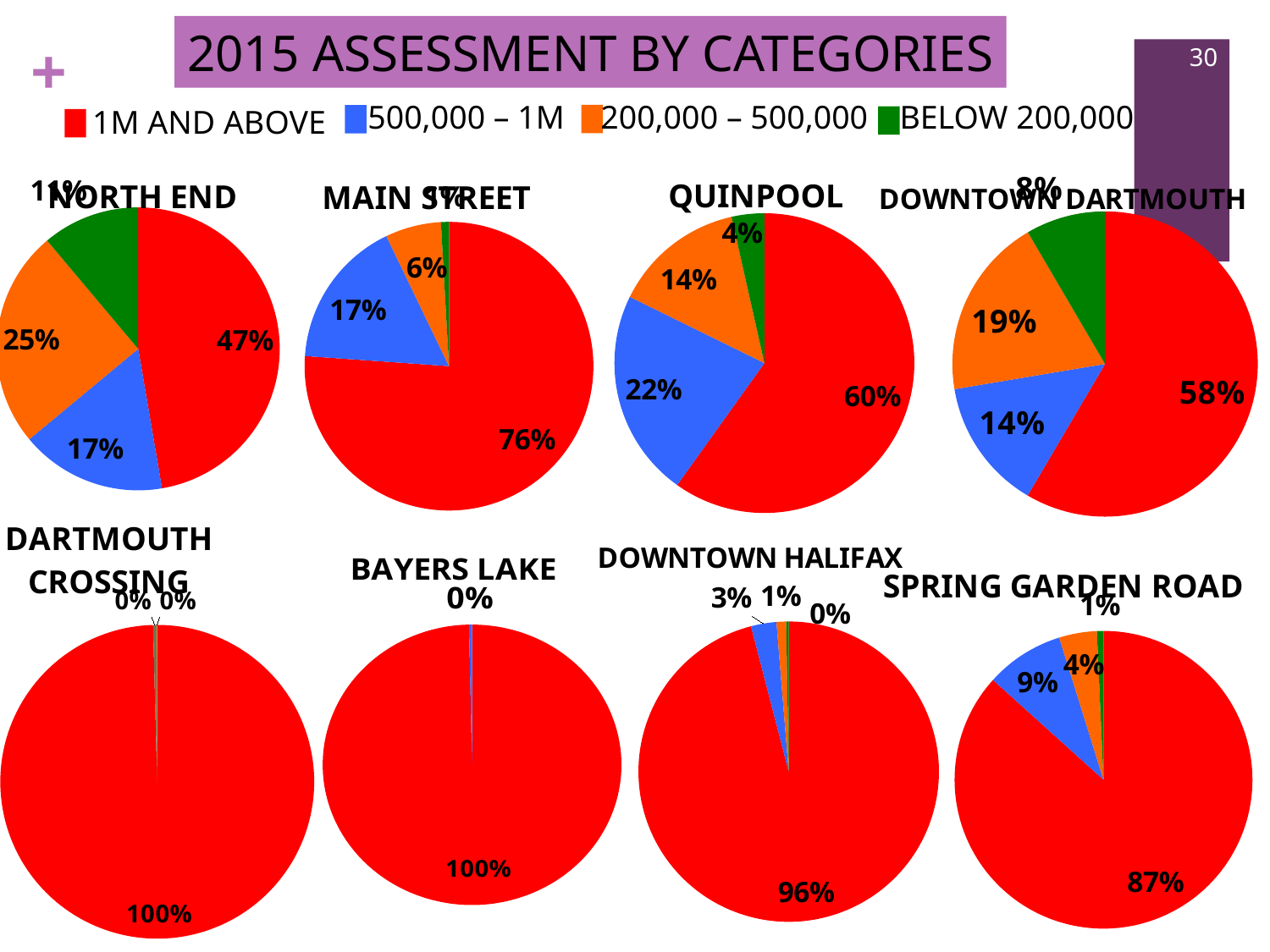
What type of chart is used for BAYERS LAKE? Pie chart In the NORTH END pie chart, what share is shown for the 1M AND ABOVE category? 47% In the QUINPOOL pie chart, what share is shown for the BELOW 200,000 category? 4% Which is larger in the NORTH END pie chart: the 200,000 – 500,000 share or the 500,000 – 1M share? 200,000 – 500,000 In the MAIN STREET pie chart, what share is shown for the 500,000 – 1M category? 17% How many categories does the legend list? 4 In the SPRING GARDEN ROAD pie chart, what share is shown for the 1M AND ABOVE category? 87% In the QUINPOOL pie chart, which category has the smallest share? BELOW 200,000 In the DOWNTOWN DARTMOUTH pie chart, what is the difference between the 1M AND ABOVE share and the 500,000 – 1M share? 44% In the DOWNTOWN DARTMOUTH pie chart, what share is shown for the 200,000 – 500,000 category? 19% In the NORTH END pie chart, what share is shown for the 200,000 – 500,000 category? 25% In the DOWNTOWN HALIFAX pie chart, which category has the largest share? 1M AND ABOVE